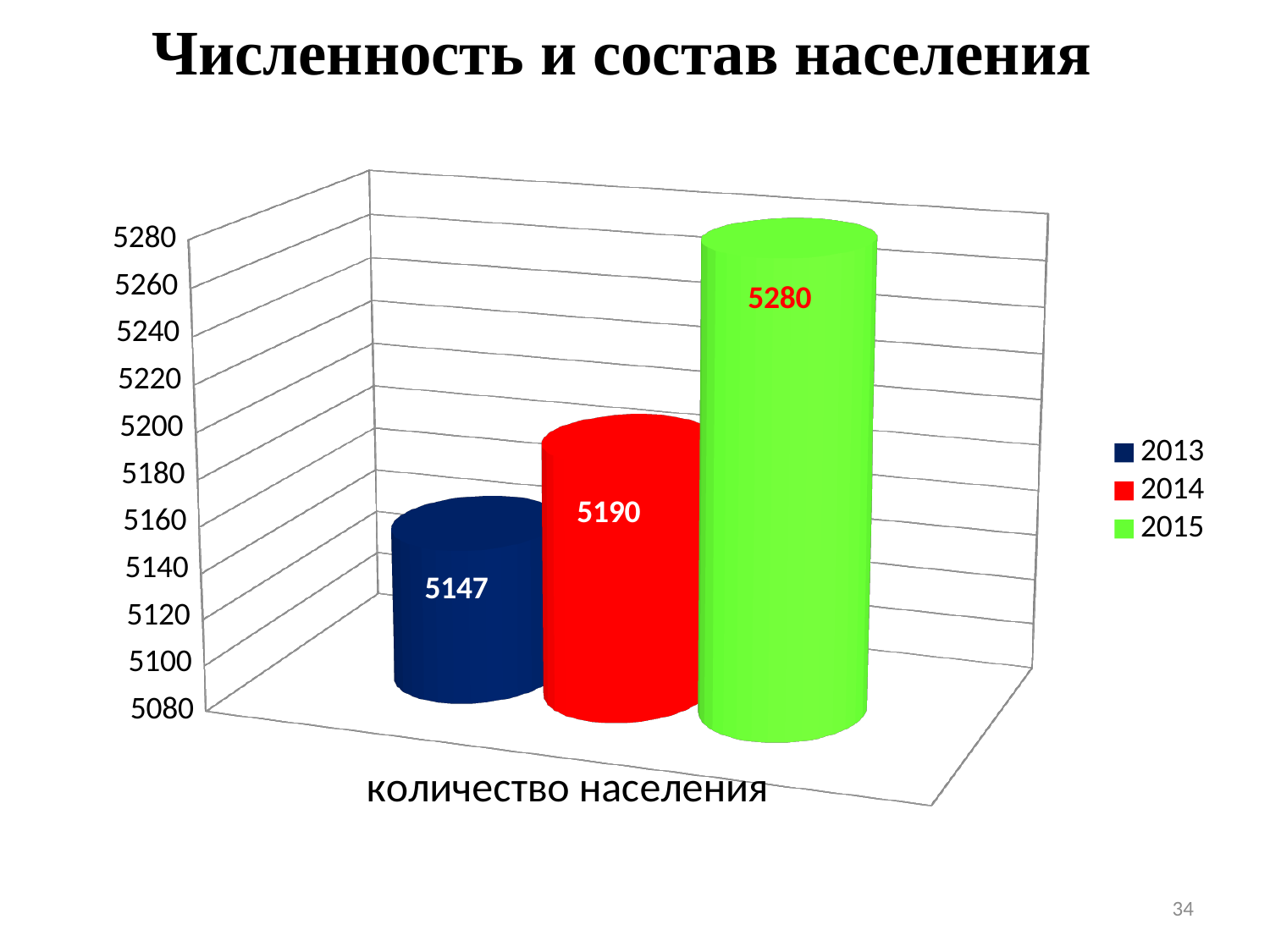
Do the values rise or fall from 2013 to 2015? rise What is the value for 2013 in the chart? 5147 What is the value for 2014 in the chart? 5190 How many series does the legend list? 3 Which is larger, the value for 2013 or the value for 2014? 2014 What is the value for 2015 in the chart? 5280 What is the difference between the values for 2015 and 2014? 90 Which year has the highest value? 2015 What kind of chart is shown on the slide? bar chart What is the difference between the values for 2014 and 2013? 43 Which year has the lowest value? 2013 Is the value for 2014 greater or less than 5200? less